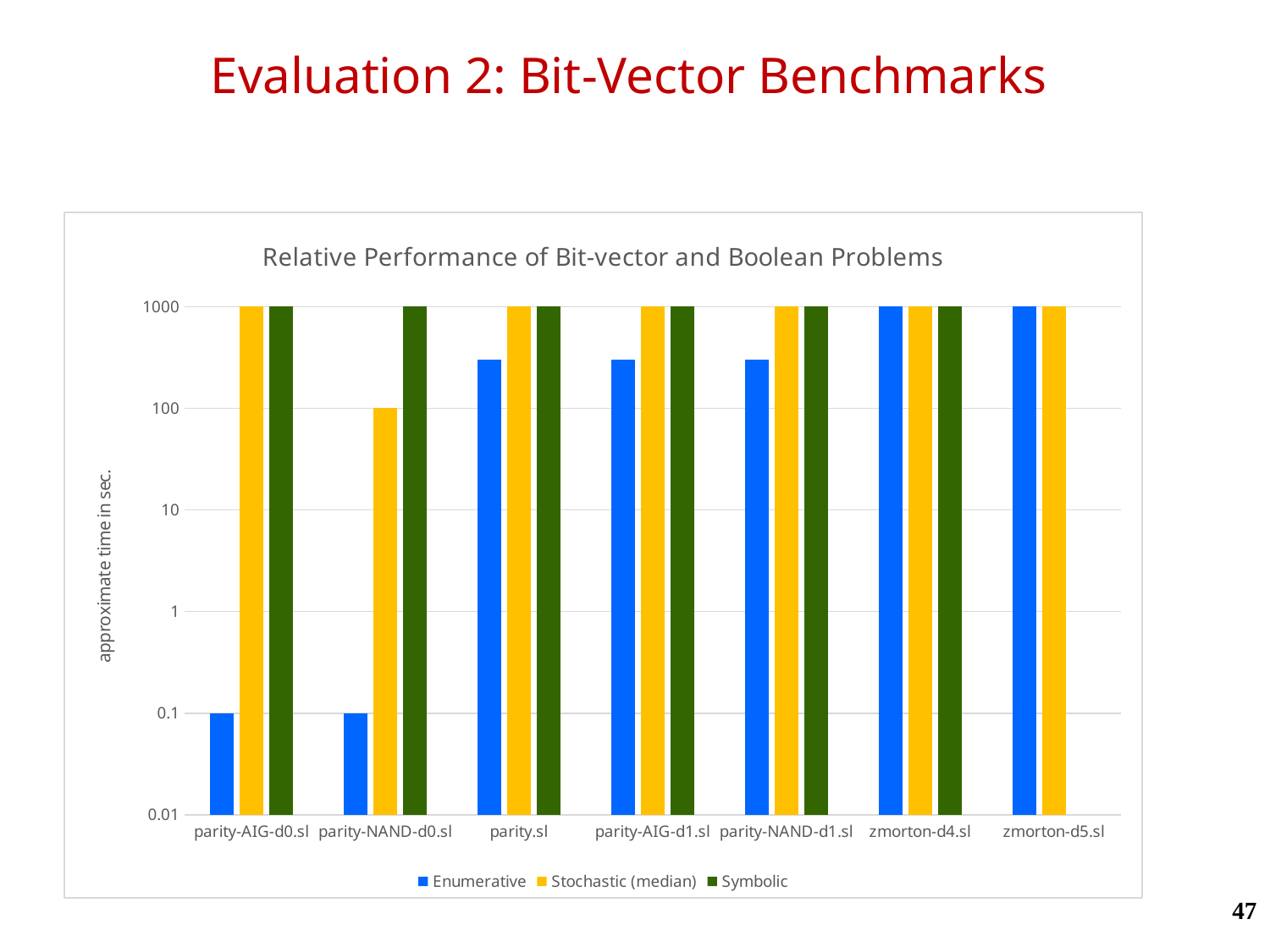
Which series has the lowest value for parity-NAND-d0.sl? Enumerative For parity-NAND-d0.sl, which is larger: the Stochastic (median) value or the Symbolic value? Symbolic What kind of chart is shown on the slide? bar chart How many benchmark categories are shown on the x axis? 7 Is the Enumerative value for parity-AIG-d1.sl greater or less than 100? greater What is the Symbolic value for parity.sl? 1000 How many series does the legend list? 3 What is the Stochastic (median) value for parity-NAND-d0.sl? 100 What is the Enumerative value for parity-AIG-d0.sl? 0.1 What is the title of the chart? Relative Performance of Bit-vector and Boolean Problems Which category has no Symbolic bar? zmorton-d5.sl Is the Enumerative value for parity.sl greater or less than 1000? less